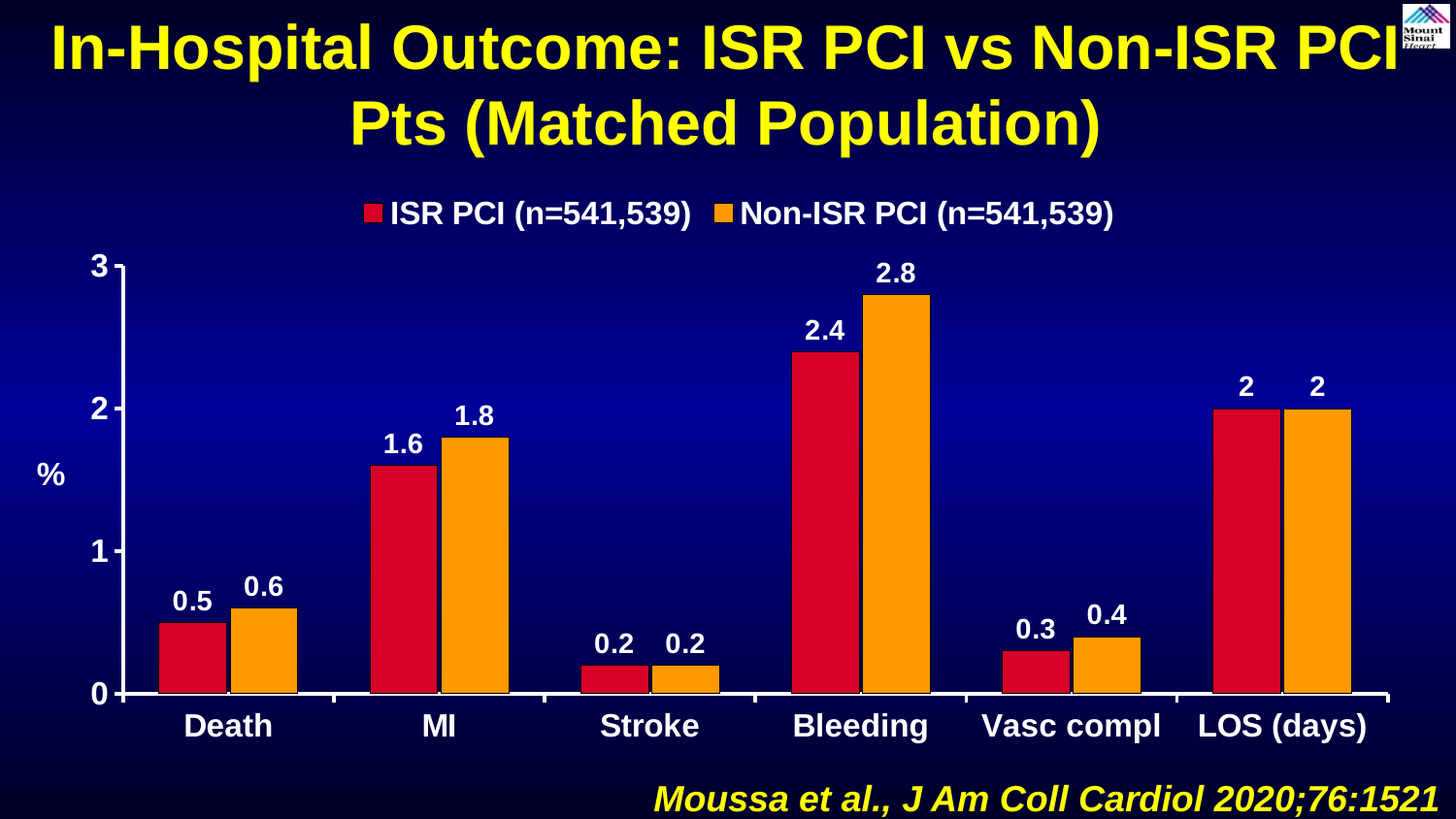
How many categories are shown on the x axis? 6 What is the value for Non-ISR PCI in the MI category? 1.8 How many series does the legend list? 2 What is the value for Non-ISR PCI in the Death category? 0.6 What is the value for ISR PCI in the Vasc compl category? 0.3 Which category has the lowest value for ISR PCI? Stroke Which category has the highest value for Non-ISR PCI? Bleeding Which is larger in the MI category, the ISR PCI value or the Non-ISR PCI value? Non-ISR PCI What kind of chart is shown on the slide? Bar chart What is the value for ISR PCI in the Bleeding category? 2.4 What is the difference between the Non-ISR PCI and ISR PCI values for Bleeding? 0.4 What colour are the bars for the Non-ISR PCI series? Orange